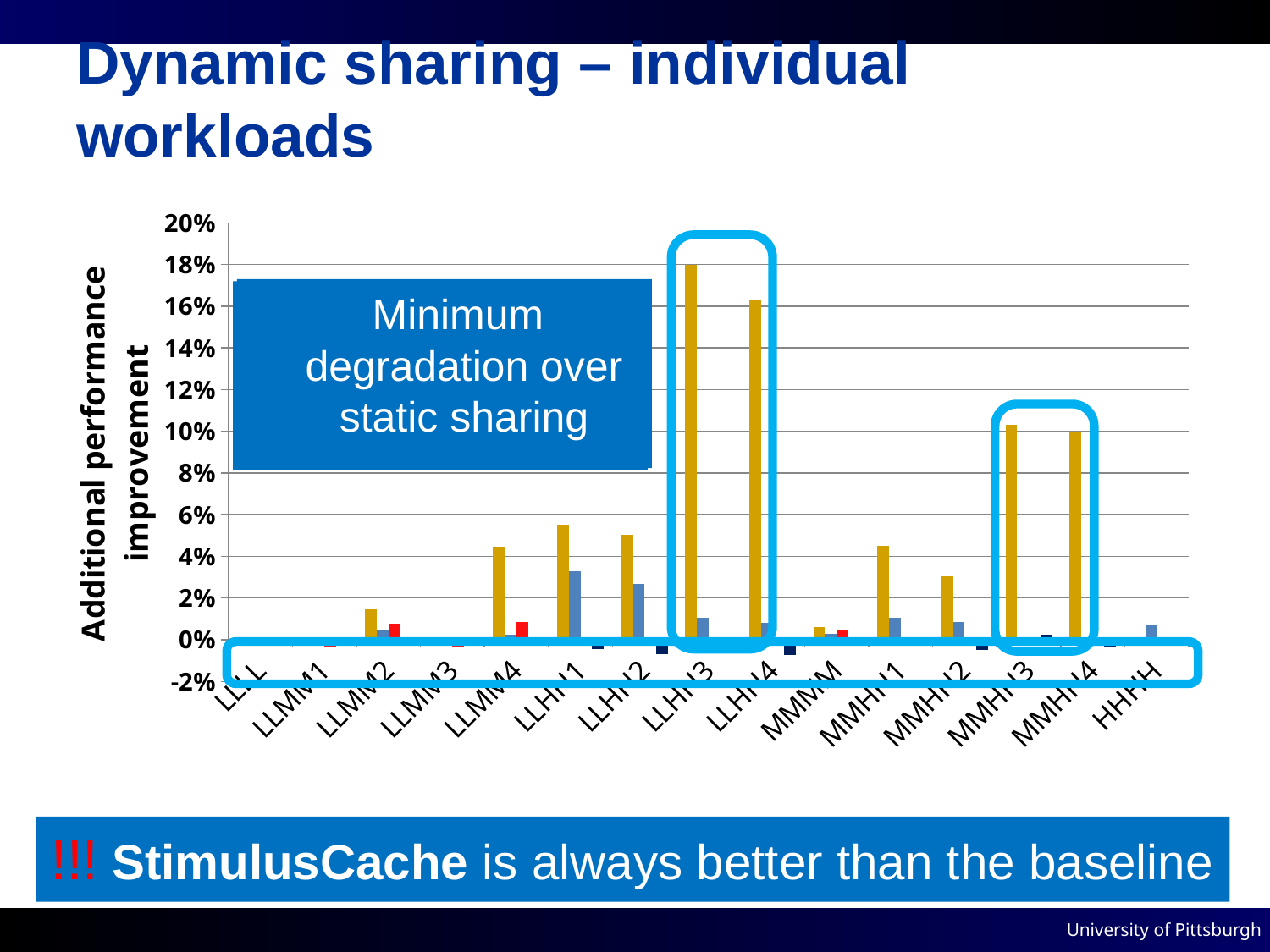
Is the tallest bar in the right cyan-highlighted group greater or less than 8%? greater Are the bars for the first category on the left greater or less than 2%? less Is the value of the tallest bar on the chart greater or less than 20%? less What text is written in the blue callout box over the chart? Minimum degradation over static sharing What kind of chart is shown on the slide? bar chart How many workload categories are plotted along the x axis? 15 Is the tallest bar in the left cyan-highlighted group taller or shorter than the tallest bar in the right cyan-highlighted group? taller What is the title of the vertical axis? Additional performance improvement